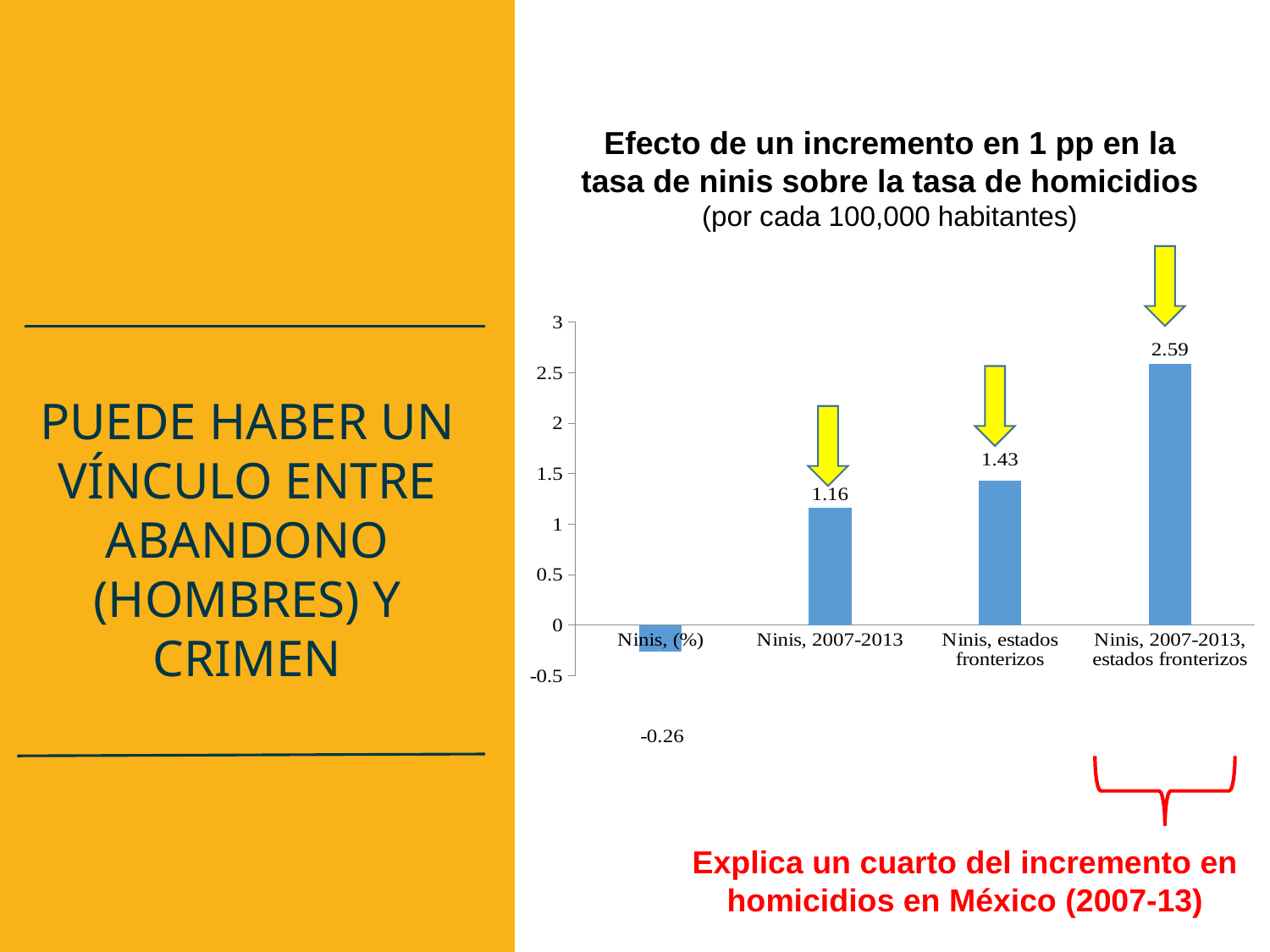
What type of chart is shown on the slide? bar chart Which category has the lowest value? Ninis, (%) Is the value for "Ninis, 2007-2013, estados fronterizos" greater or less than 2.5? greater What is the value for "Ninis, 2007-2013, estados fronterizos"? 2.59 What is the title of the chart? Efecto de un incremento en 1 pp en la tasa de ninis sobre la tasa de homicidios (por cada 100,000 habitantes) What is the value for "Ninis, (%)"? -0.26 Which category has the highest value? Ninis, 2007-2013, estados fronterizos What is the difference between the values for "Ninis, 2007-2013, estados fronterizos" and "Ninis, estados fronterizos"? 1.16 What is the value for "Ninis, 2007-2013"? 1.16 What is the value for "Ninis, estados fronterizos"? 1.43 How many categories are plotted in the chart? 4 Which is larger, the value for "Ninis, estados fronterizos" or the value for "Ninis, 2007-2013"? Ninis, estados fronterizos